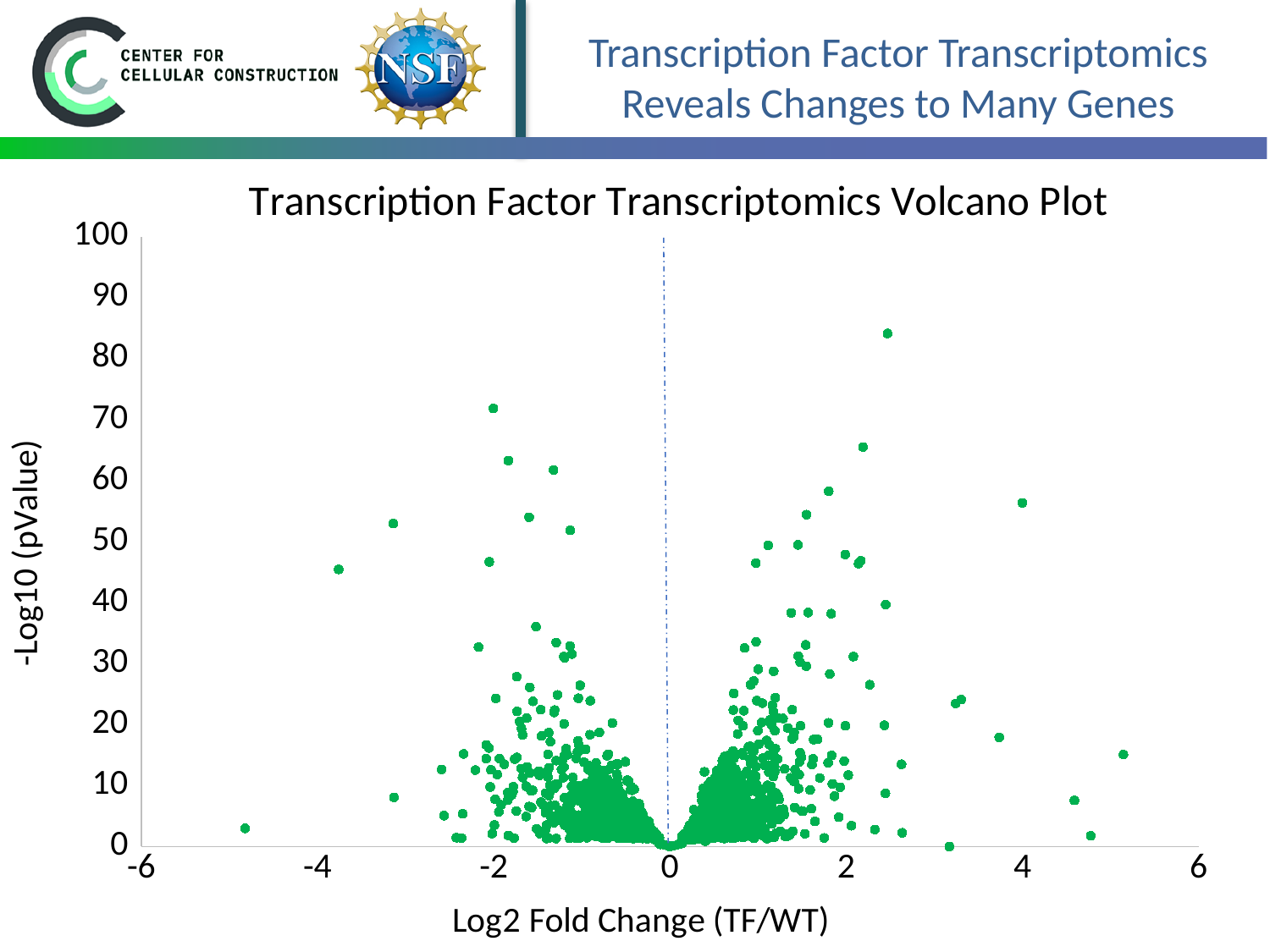
What is the maximum value shown on the y axis? 100 Is the -Log10 (pValue) of the leftmost point (near Log2 Fold Change -5) greater or less than 10? less Is the -Log10 (pValue) of the highest point on the chart greater or less than 80? greater What kind of chart is shown on the slide? Scatter plot Is the -Log10 (pValue) of the isolated point near Log2 Fold Change -3.8 greater or less than 40? greater Does the highest point on the chart lie on the positive or the negative side of the Log2 Fold Change axis? positive What is the title of the chart? Transcription Factor Transcriptomics Volcano Plot What is the label of the y axis? -Log10 (pValue) Which side of the chart has the higher topmost point, the left (negative Log2 Fold Change) side or the right (positive) side? right side What is the label of the x axis? Log2 Fold Change (TF/WT)